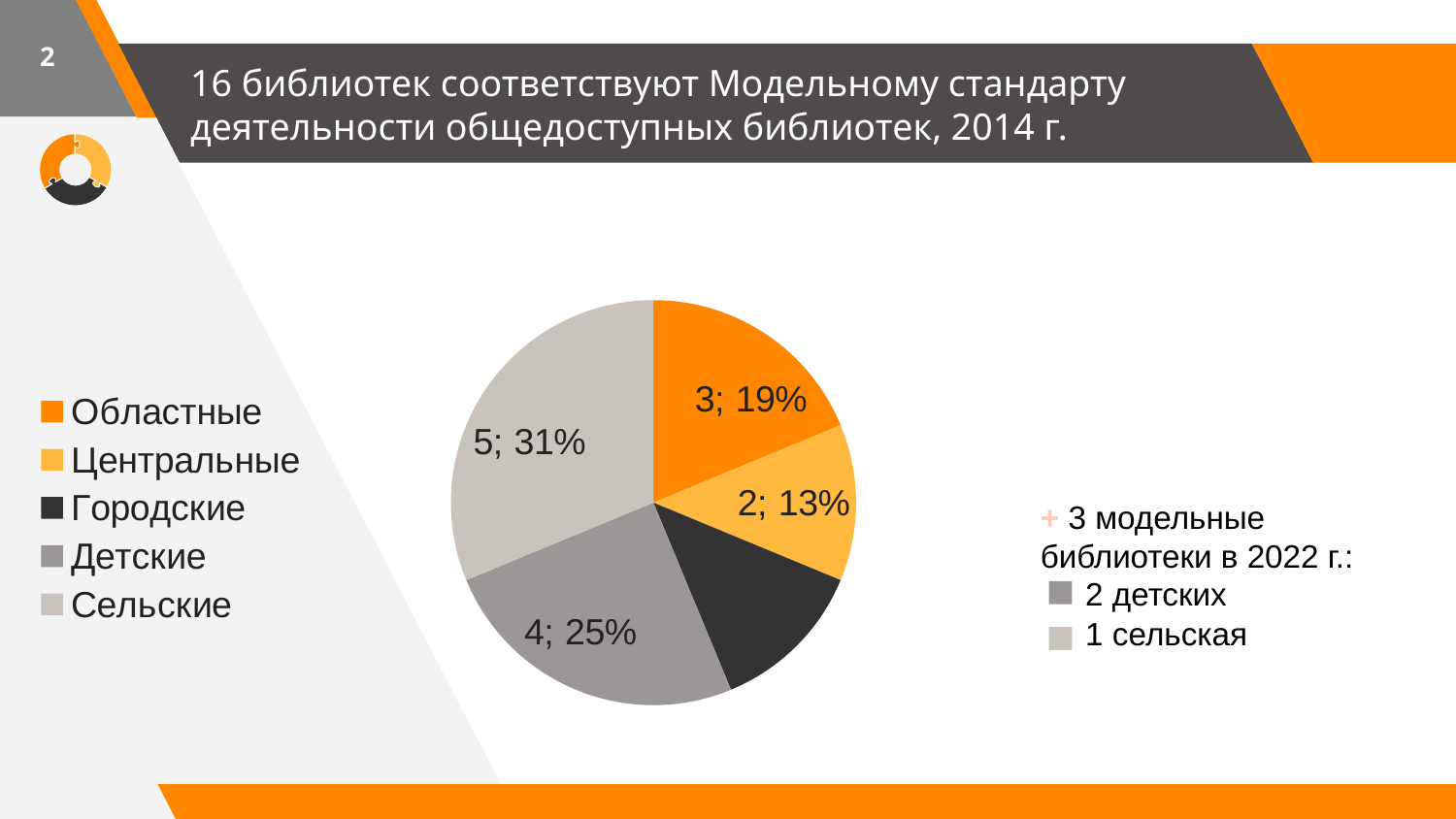
What share of the pie does the Центральные slice represent? 13% What kind of chart is shown on the slide? pie chart Which legend entry is shown in the darkest colour? Городские What share of the pie does the Сельские slice represent? 31% What is the difference between the number of libraries in the Детские slice and the Центральные slice? 2 How many categories does the legend of the pie chart list? 5 How many libraries does the Детские slice represent? 4 Which slice is larger, Областные or Детские? Детские Which slice is larger, Сельские or Детские? Сельские What is the difference between the number of libraries in the Сельские slice and the Областные slice? 2 What value is shown for the Областные slice of the pie chart? 3; 19% Which category has the largest slice in the pie chart? Сельские